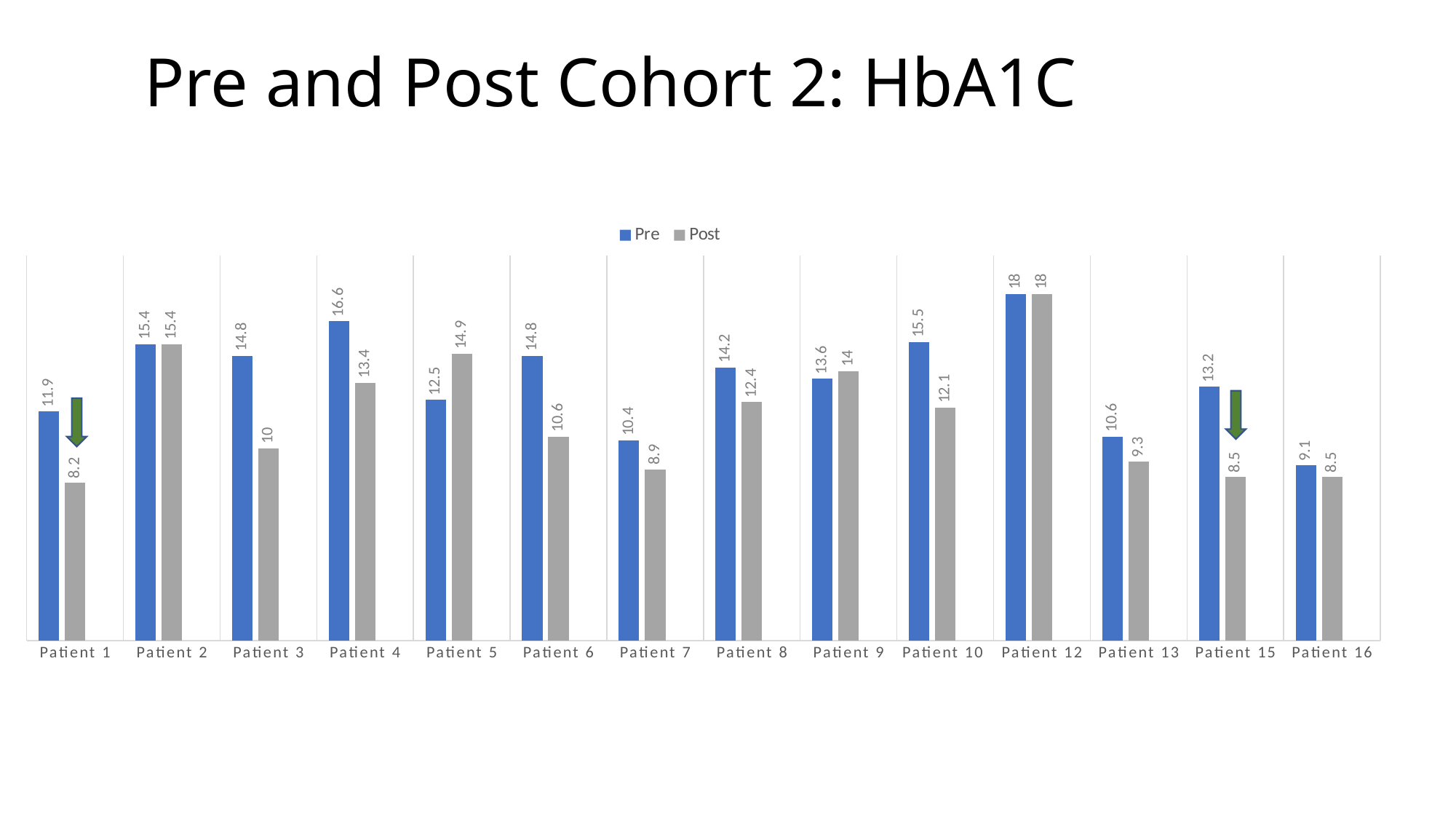
What is the difference between the Pre and Post values for Patient 3? 4.8 How many patients are shown on the x axis? 14 For Patient 9, which is larger, the Pre value or the Post value? Post What is the difference between the Pre and Post values for Patient 4? 3.2 What kind of chart is shown on the slide? Bar chart Which patient has the highest Pre value? Patient 12 What is the Post value for Patient 5? 14.9 What is the Pre value for Patient 1? 11.9 Which patient has the lowest Post value? Patient 1 What is the Post value for Patient 15? 8.5 Which patient has the lowest Pre value? Patient 16 How many series does the legend list? 2